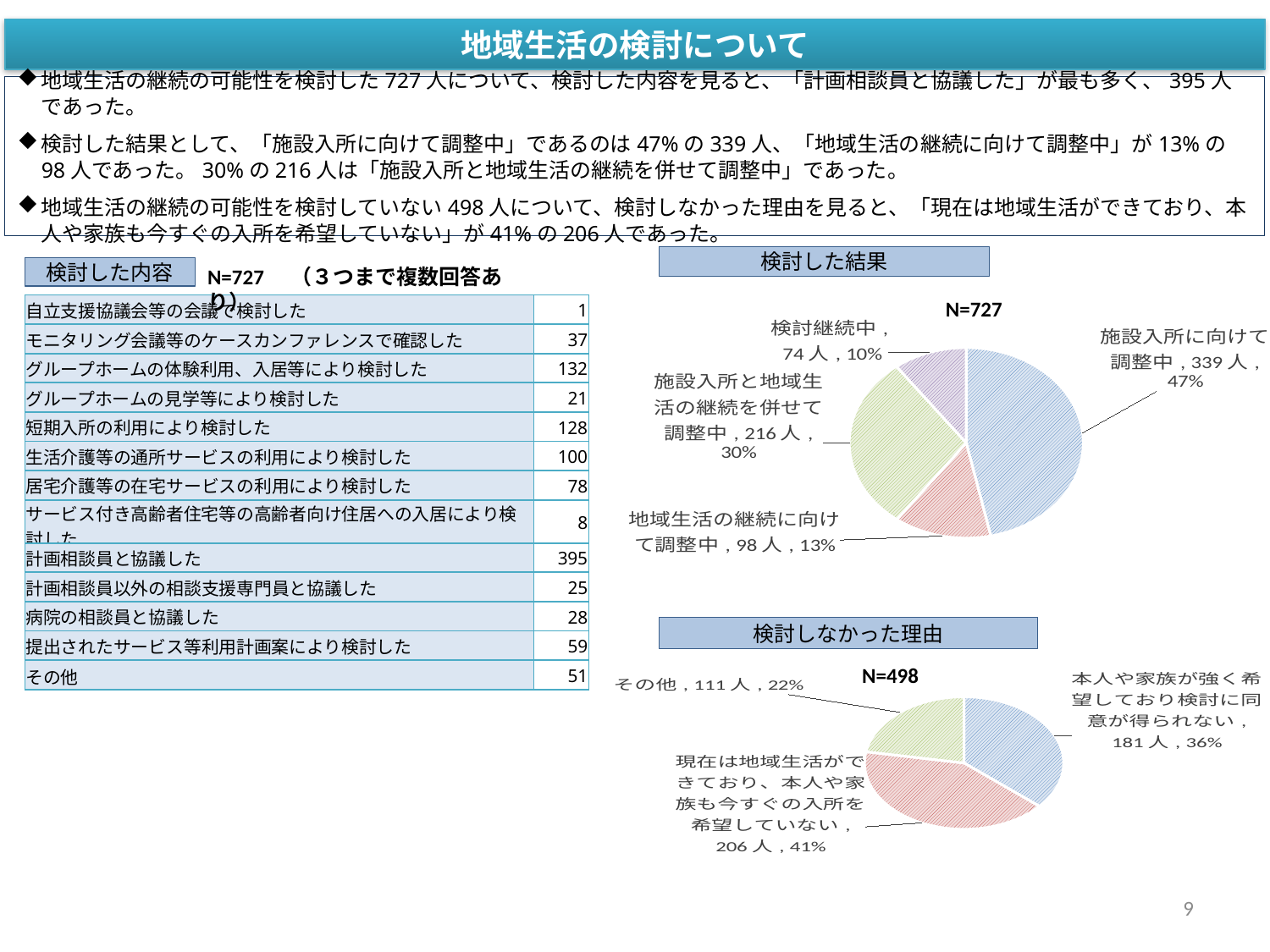
「検討しなかった理由」の円グラフで、「本人や家族が強く希望しており検討に同意が得られない」の割合は何%ですか？ 36% 「検討した結果」の円グラフには項目がいくつありますか？ 4 「検討しなかった理由」の円グラフで、「その他」の人数はいくつですか？ 111人 「検討した結果」の円グラフで、「施設入所と地域生活の継続を併せて調整中」と「地域生活の継続に向けて調整中」ではどちらの人数が多いですか？ 施設入所と地域生活の継続を併せて調整中 「検討した結果」の円グラフで、「施設入所に向けて調整中」と「地域生活の継続に向けて調整中」の人数の差はいくつですか？ 241人 「検討した結果」の円グラフで、最も割合が小さい項目はどれですか？ 検討継続中 「検討した結果」の円グラフで、「施設入所に向けて調整中」の人数はいくつですか？ 339人 「検討した結果」の円グラフで、最も割合が大きい項目はどれですか？ 施設入所に向けて調整中 「検討しなかった理由」の円グラフで、最も割合が大きい項目はどれですか？ 現在は地域生活ができており、本人や家族も今すぐの入所を希望していない 「検討した結果」の円グラフで、「検討継続中」の割合は何%ですか？ 10% 「検討しなかった理由」の円グラフのNはいくつですか？ N=498 「検討した結果」のグラフはどの種類のグラフですか？ 円グラフ